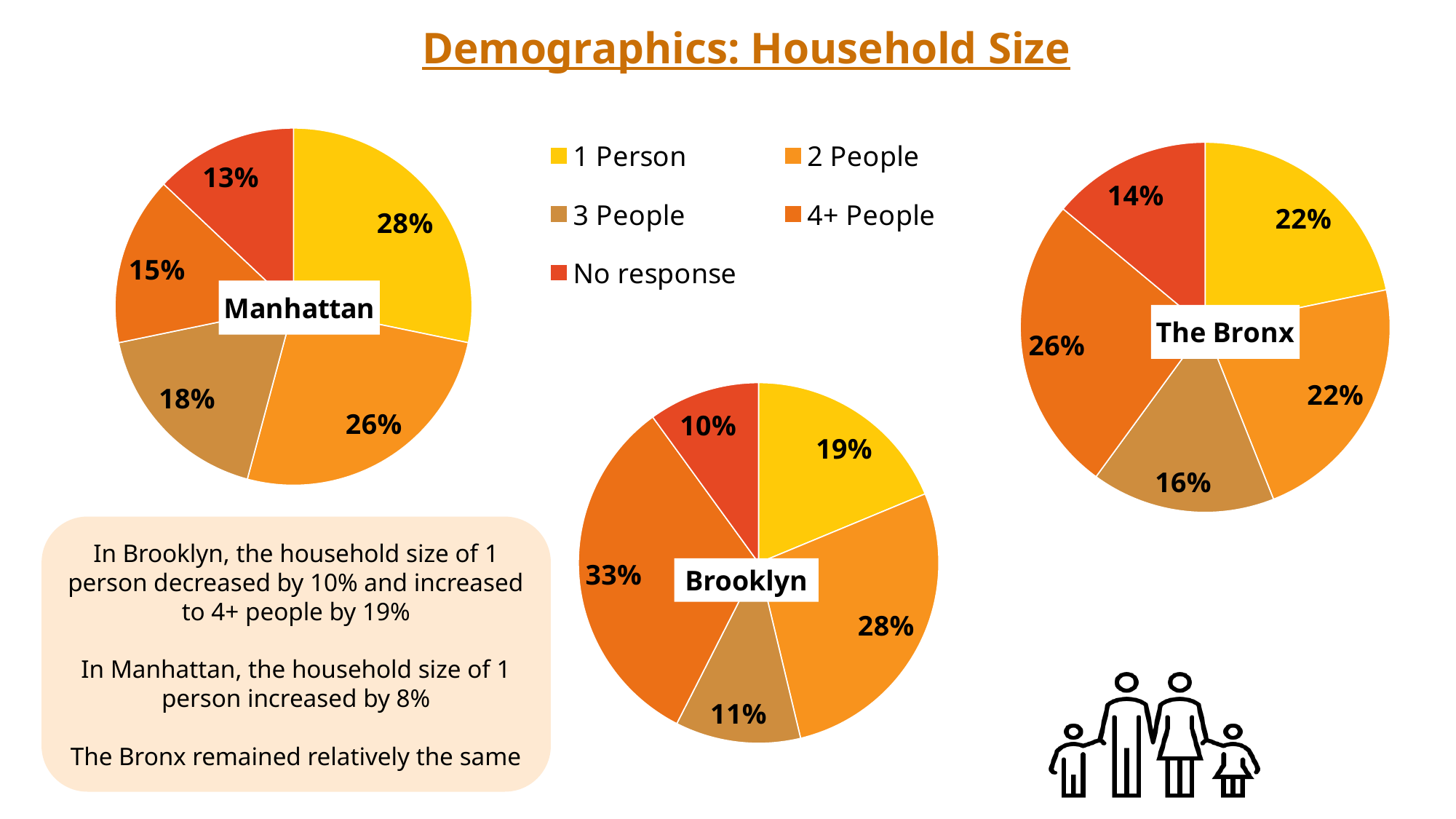
How many slices does the Brooklyn pie chart have? 5 What type of chart is used for Manhattan, Brooklyn and The Bronx? Pie chart In the Manhattan pie chart, which category has the smallest slice? No response In the Brooklyn pie chart, what share of households are 4+ People? 33% In the Brooklyn pie chart, which category has the largest slice? 4+ People In the Manhattan pie chart, which is larger: the 3 People slice or the 4+ People slice? 3 People In the Manhattan pie chart, what share of households are 1 Person? 28% In The Bronx pie chart, what share of households are 3 People? 16% In the Manhattan pie chart, what is the combined share of 1 Person and 2 People households? 54% In The Bronx pie chart, which category has the largest slice? 4+ People How many categories does the legend list? 5 In the Brooklyn pie chart, what is the difference between the 2 People share and the 3 People share? 17%